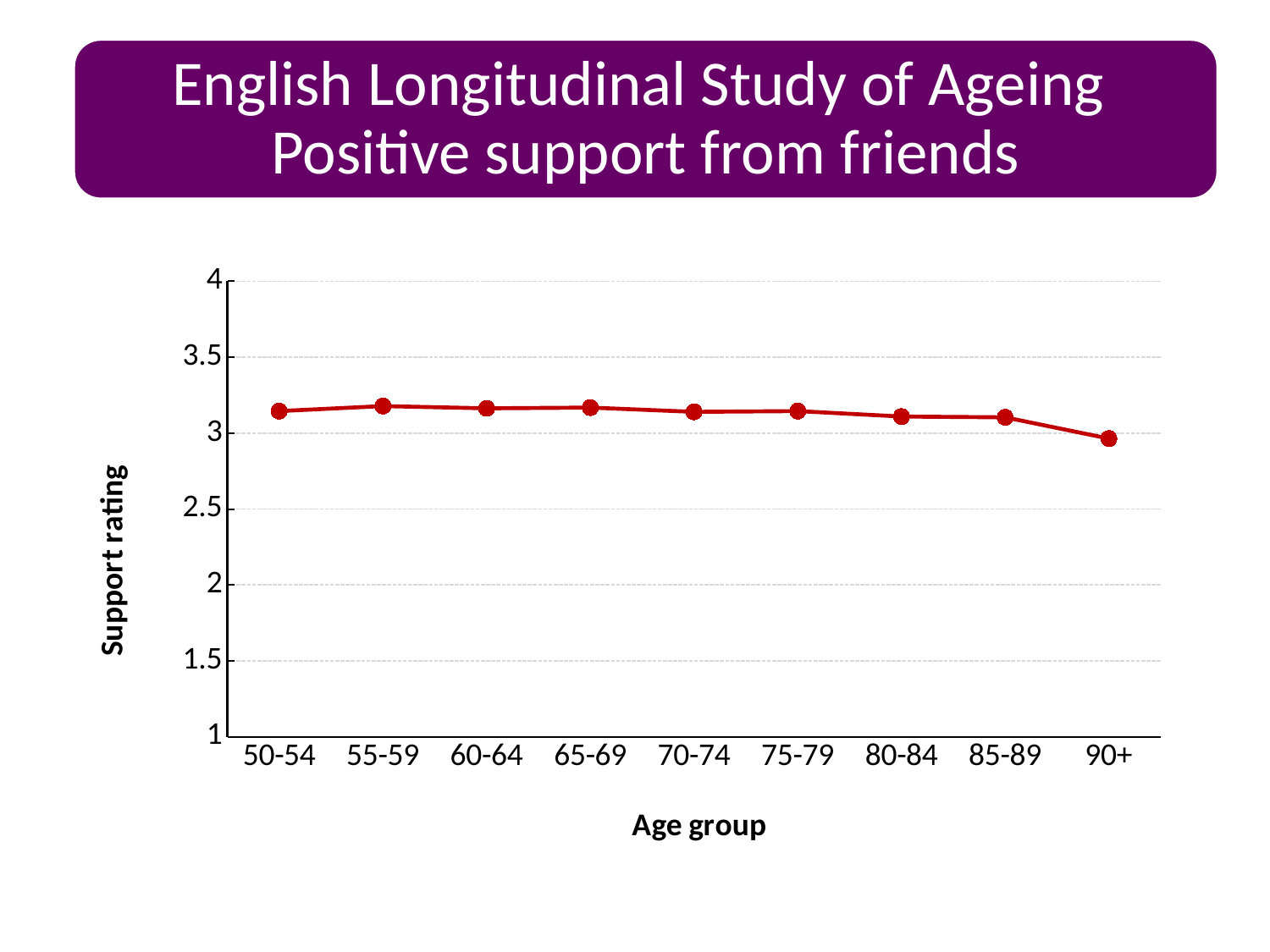
Is the support rating for the 85-89 age group greater or less than 3? greater Is the support rating for the 65-69 age group greater or less than 3.5? less Which age group has the lowest support rating? 90+ Is the support rating for the 90+ age group greater or less than 3? less Does the support rating generally rise or fall from the 65-69 age group to the 90+ age group? fall What kind of chart is shown on the slide? line chart What is the label of the x axis? Age group Which has the higher support rating, the 80-84 age group or the 90+ age group? 80-84 What is the label of the y axis? Support rating Which has the higher support rating, the 55-59 age group or the 90+ age group? 55-59 How many age groups are plotted on the x axis? 9